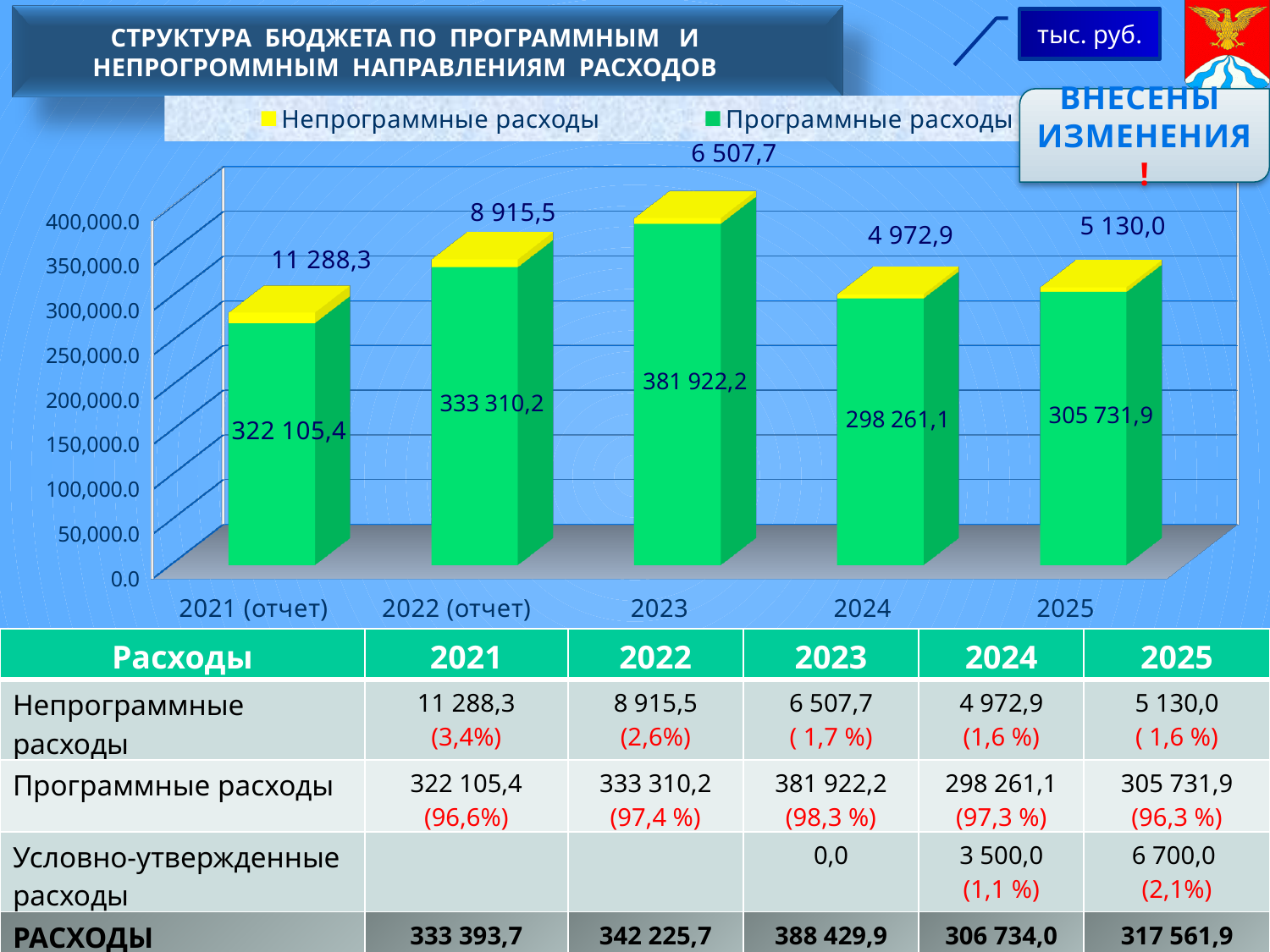
What kind of chart is shown on the slide? Stacked bar chart What is the total of the stacked bar for 2021 (отчет)? 333 393,7 Which is larger: Программные расходы in 2025 or in 2024? 2025 What is the value of Непрограммные расходы for 2025? 5 130,0 What is the value of Непрограммные расходы for 2021 (отчет)? 11 288,3 How many series does the chart legend list? 2 In which year is Программные расходы highest? 2023 In which year is Программные расходы lowest? 2024 What is the difference between Программные расходы in 2023 and in 2022 (отчет)? 48 612,0 In which year is Непрограммные расходы highest? 2021 (отчет) How many years are shown on the x axis of the chart? 5 What is the value of Программные расходы for 2023? 381 922,2